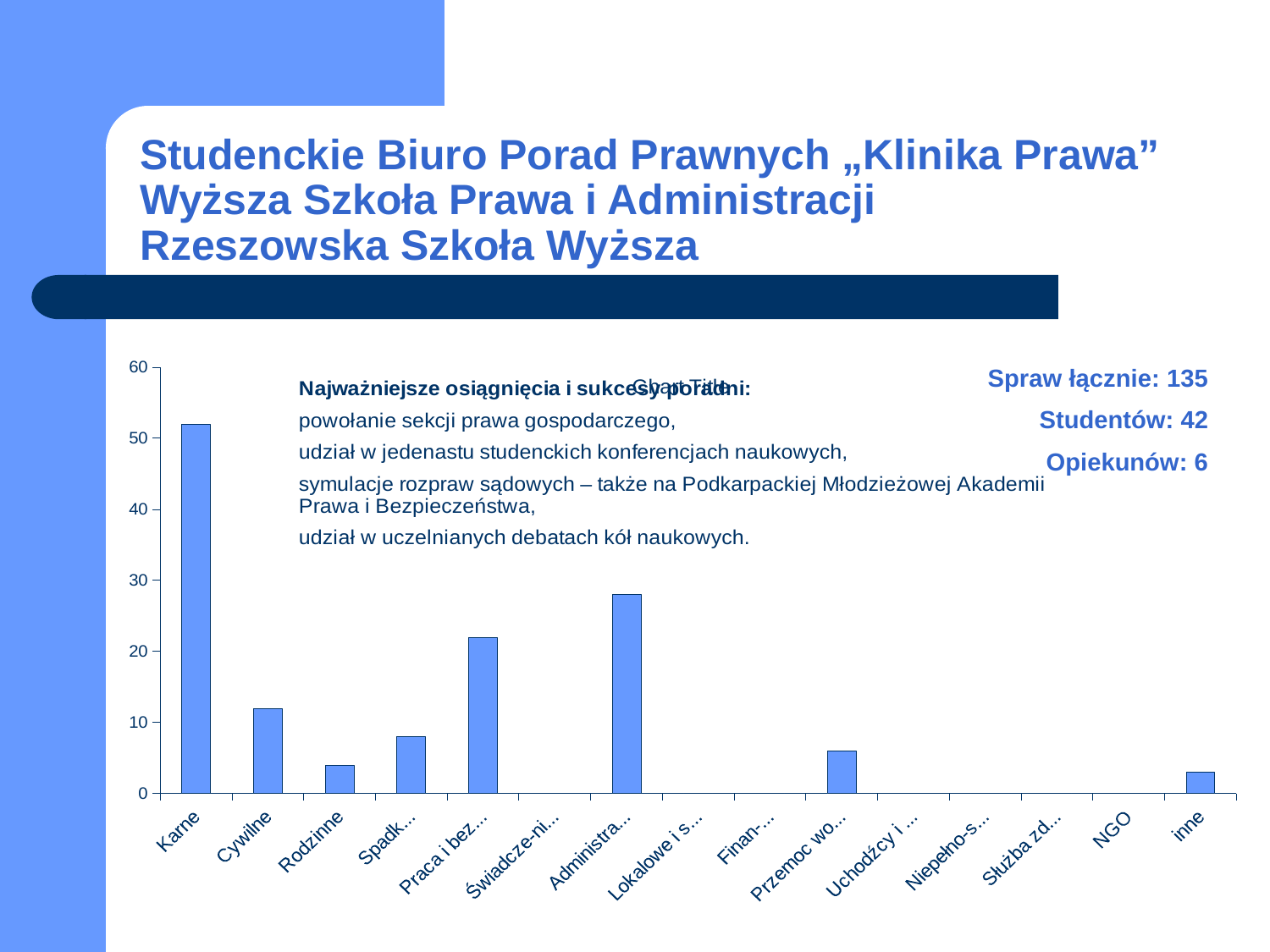
Is the value for Cywilne greater or less than 20? less How many categories are shown along the x axis of the chart? 15 Is the value for Rodzinne greater or less than 10? less Which is larger, the value for Administra... or the value for Praca i bez...? Administra... Is the value for Administra... greater or less than 20? greater Which is larger, the value for Karne or the value for Administra...? Karne What is the highest value shown on the vertical axis of the chart? 60 What kind of chart is shown on the slide? bar chart Which category has the highest bar in the chart? Karne Which is larger, the value for Praca i bez... or the value for Cywilne? Praca i bez...